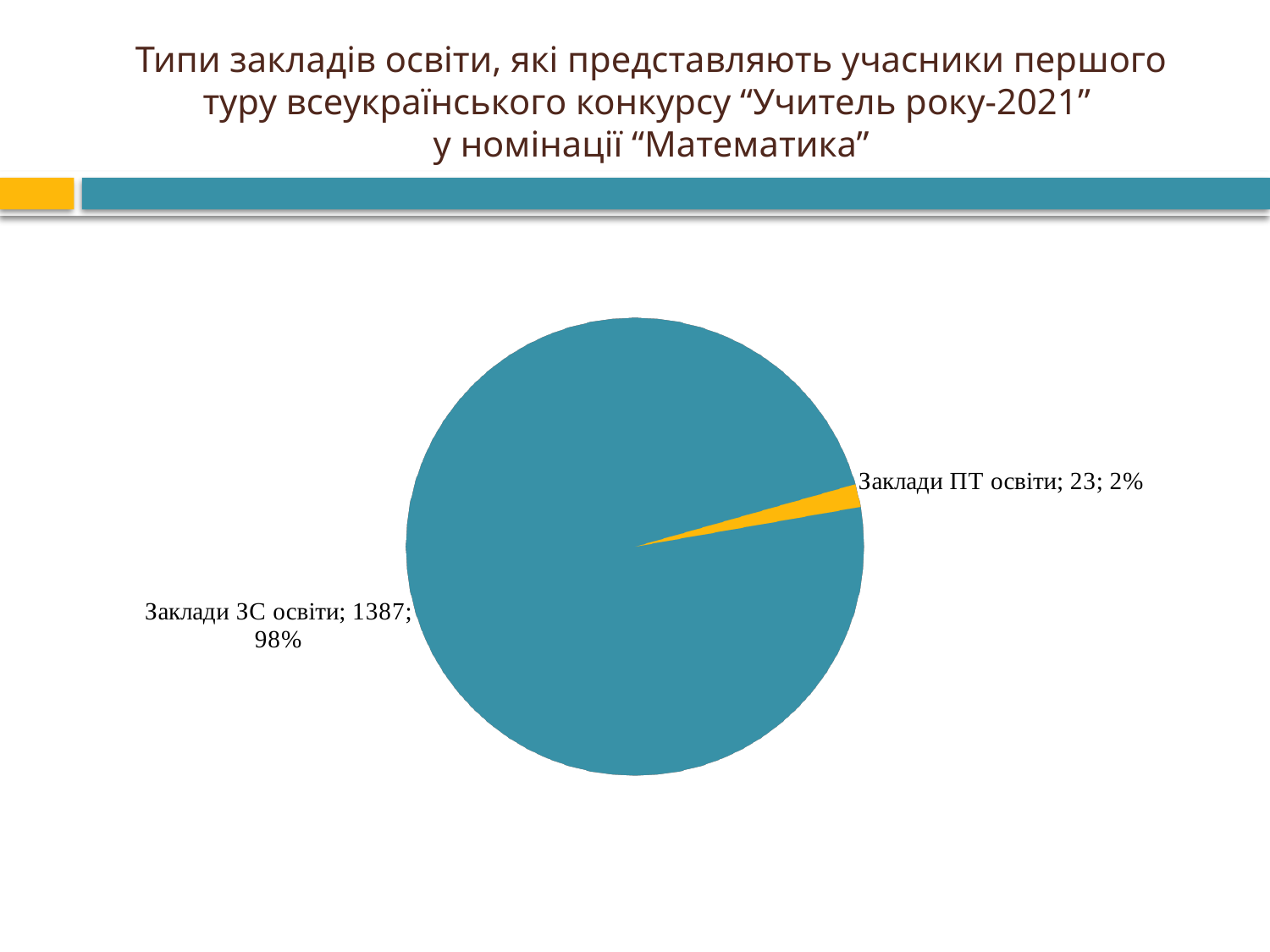
What is the total of the two slices in the pie chart? 1410 How many slices does the pie chart have? 2 What is the difference between the values for Заклади ЗС освіти and Заклади ПТ освіти? 1364 Which is larger, Заклади ЗС освіти or Заклади ПТ освіти? Заклади ЗС освіти What colour is the slice for Заклади ПТ освіти? yellow What kind of chart is shown on the slide? pie chart Which category has the smallest slice? Заклади ПТ освіти Which category has the largest slice? Заклади ЗС освіти What is the value for Заклади ЗС освіти? 1387 What is the value for Заклади ПТ освіти? 23 What share of the pie does Заклади ПТ освіти represent? 2% What share of the pie does Заклади ЗС освіти represent? 98%